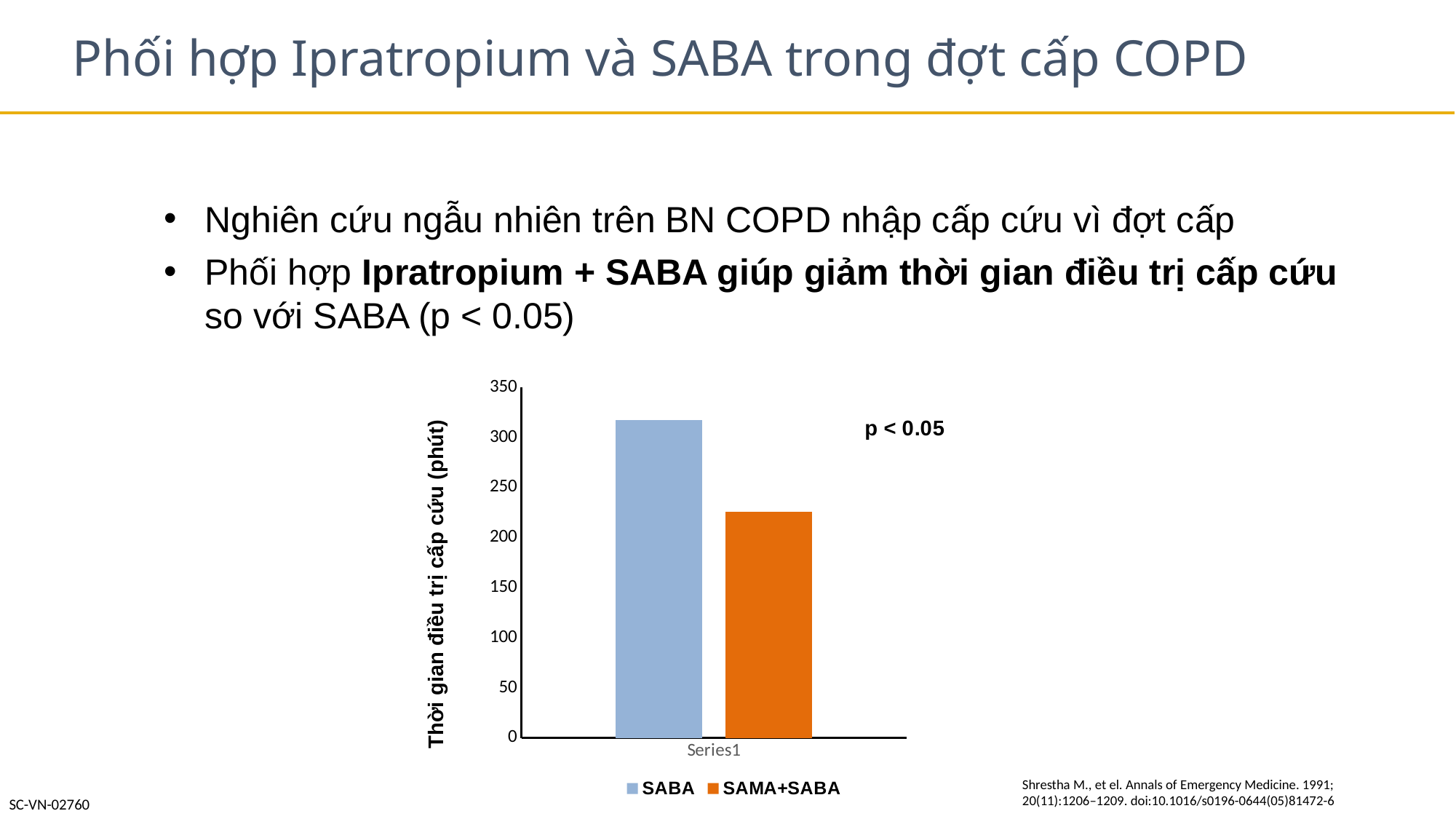
How many series does the legend list? 2 How many categories are shown on the x axis? 1 Is the value for SABA greater or less than 350? less Is the value for SABA greater or less than 300? greater What is the label of the vertical axis? Thời gian điều trị cấp cứu (phút) Which series has the taller bar, SABA or SAMA+SABA? SABA Is the value for SAMA+SABA greater or less than 200? greater Which series has the lowest value in the chart? SAMA+SABA What p-value annotation is printed on the chart? p < 0.05 Which series has the highest value in the chart? SABA What kind of chart is shown on the slide? bar chart